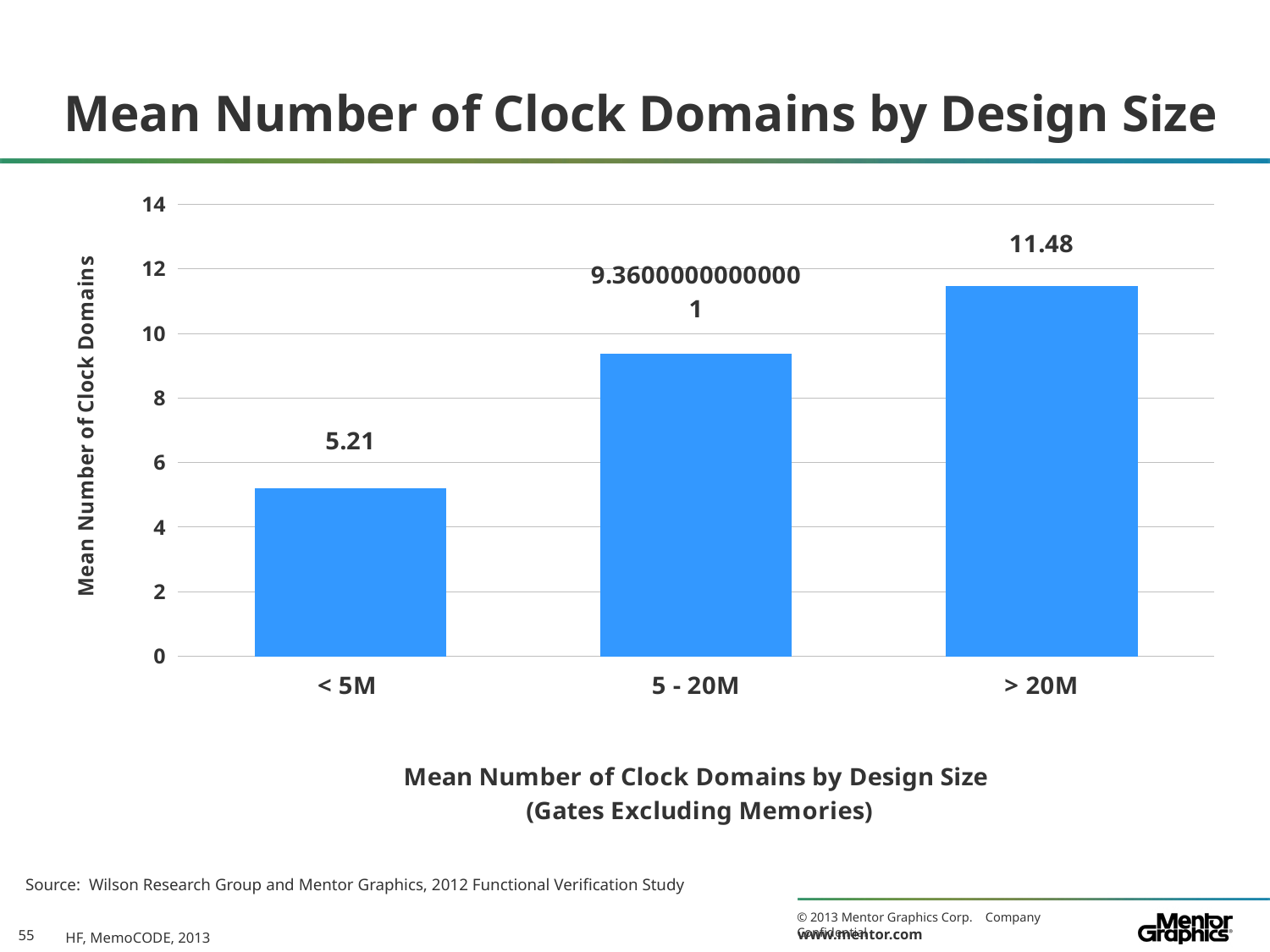
What is the difference between the mean number of clock domains for > 20M designs and < 5M designs? 6.27 What is the label of the y axis? Mean Number of Clock Domains Do the values rise or fall as design size increases along the x axis? rise Is the mean number of clock domains for < 5M designs greater or less than 6? less How many design size categories are shown in the chart? 3 What kind of chart is shown on the slide? bar chart Which design size has the highest mean number of clock domains? > 20M What is the mean number of clock domains for designs of size < 5M? 5.21 What is the mean number of clock domains for designs of size > 20M? 11.48 Is the mean number of clock domains for 5 - 20M designs greater or less than 8? greater Which has a larger mean number of clock domains, 5 - 20M designs or > 20M designs? > 20M Which design size has the lowest mean number of clock domains? < 5M